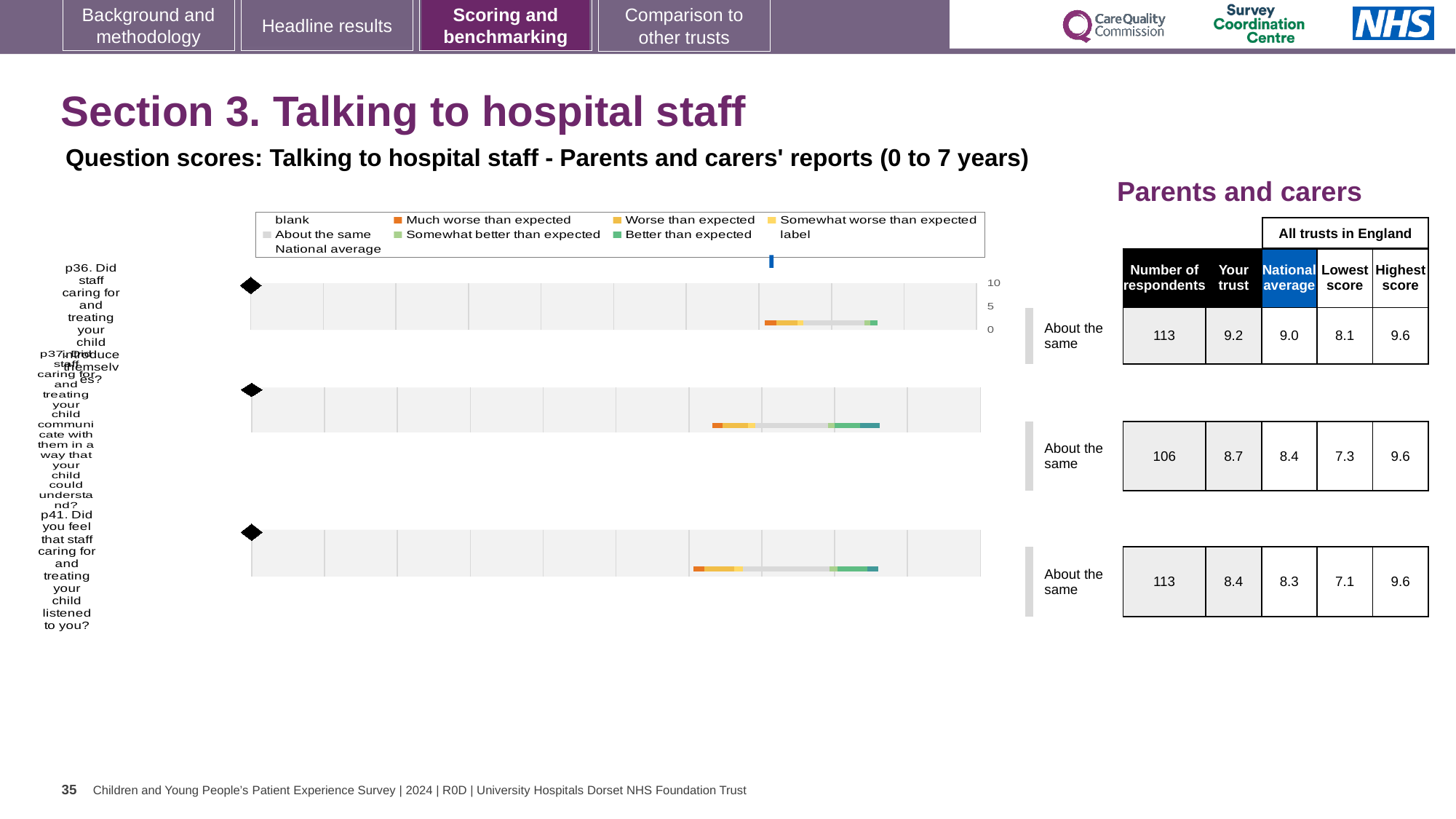
In the table beside the charts, what is the 'Your trust' score for p36 (Did staff caring for and treating your child introduce themselves)? 9.2 What kind of chart is used to show the question scores on this slide? bar chart What is the difference between the 'Your trust' score and the National average for p36? 0.2 For p41, which is larger: the 'Your trust' score or the National average? Your trust How many entries does the chart legend list? 9 Which of the three questions has the highest 'Your trust' score in the table beside the charts? p36 How many survey questions (categories) are plotted in the charts on this slide? 3 In the table beside the charts, how many respondents are listed for p37 (Did staff communicate with them in a way that your child could understand)? 106 What is the maximum value shown on the chart's score axis? 10 What colour does the legend use for 'Much worse than expected'? orange What benchmark label is shown next to each of the three charts? About the same In the table beside the charts, what is the National average for p41 (Did you feel that staff caring for and treating your child listened to you)? 8.3